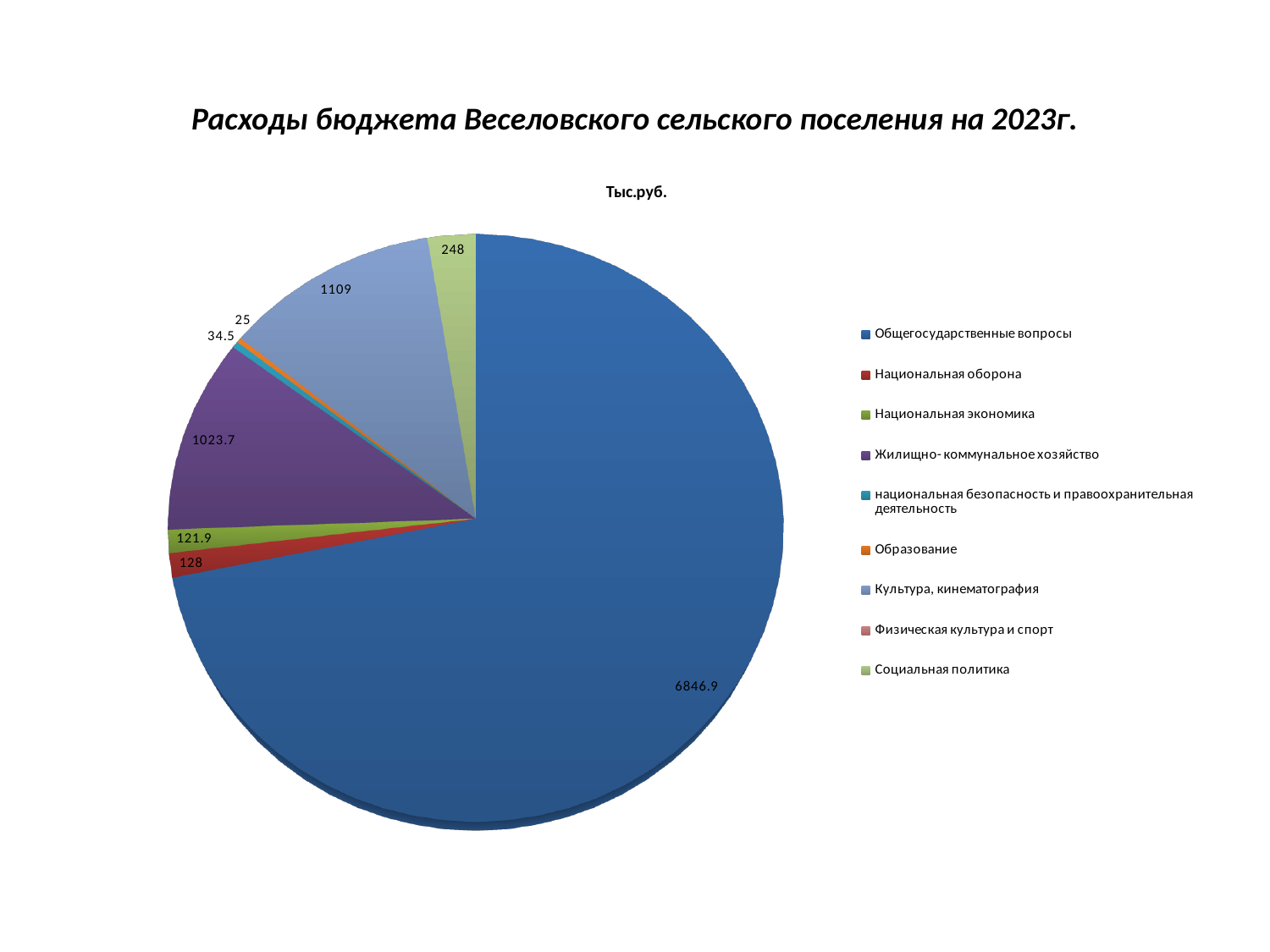
What is the value for Общегосударственные вопросы? 6846.9 What kind of chart is shown on the slide? pie chart What is the value for Культура, кинематография? 1109 What is the title shown above the pie chart? Тыс.руб. How many categories does the legend list? 9 What is the value for Социальная политика? 248 Which is larger, the value for Национальная оборона or the value for Национальная экономика? Национальная оборона What is the value for Жилищно- коммунальное хозяйство? 1023.7 Which category has the largest slice of the pie? Общегосударственные вопросы What is the difference between the values for Культура, кинематография and Жилищно- коммунальное хозяйство? 85.3 What is the value for Образование? 25 What is the value for Национальная оборона? 128